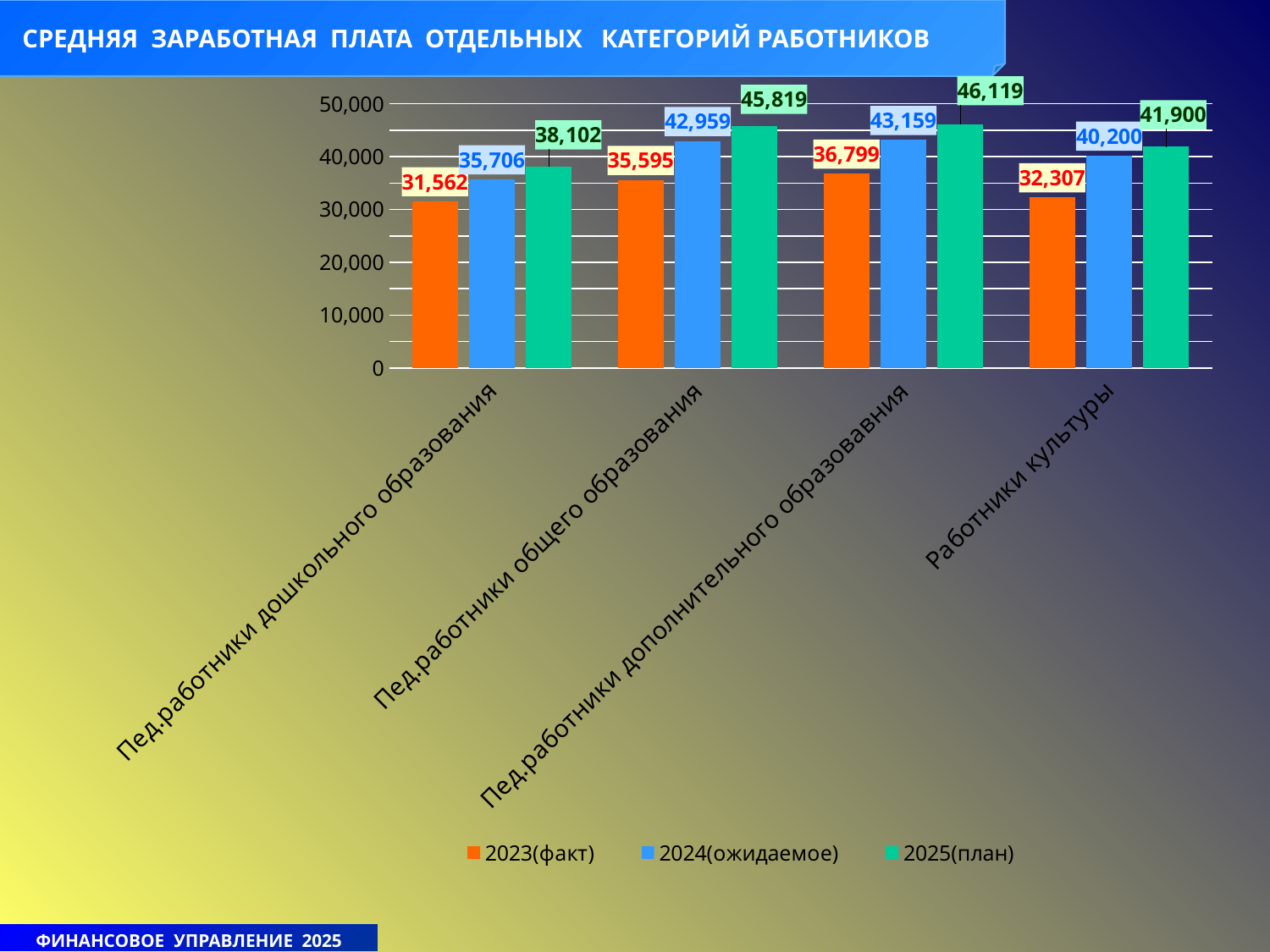
What is the 2023(факт) value for Пед.работники дошкольного образования? 31,562 Which category has the lowest 2023(факт) value? Пед.работники дошкольного образования What is the difference between the 2025(план) and 2023(факт) values for Работники культуры? 9,593 Which category has the highest 2025(план) value? Пед.работники дополнительного образовавния What colour are the 2023(факт) bars? orange Which is larger: the 2024(ожидаемое) value for Пед.работники общего образования or for Пед.работники дополнительного образовавния? Пед.работники дополнительного образовавния What type of chart is shown on the slide? bar chart How many categories are shown on the x axis? 4 How many series does the legend list? 3 Is the 2025(план) value for Пед.работники дошкольного образования greater or less than 40,000? less What is the 2025(план) value for Пед.работники общего образования? 45,819 What is the 2024(ожидаемое) value for Работники культуры? 40,200